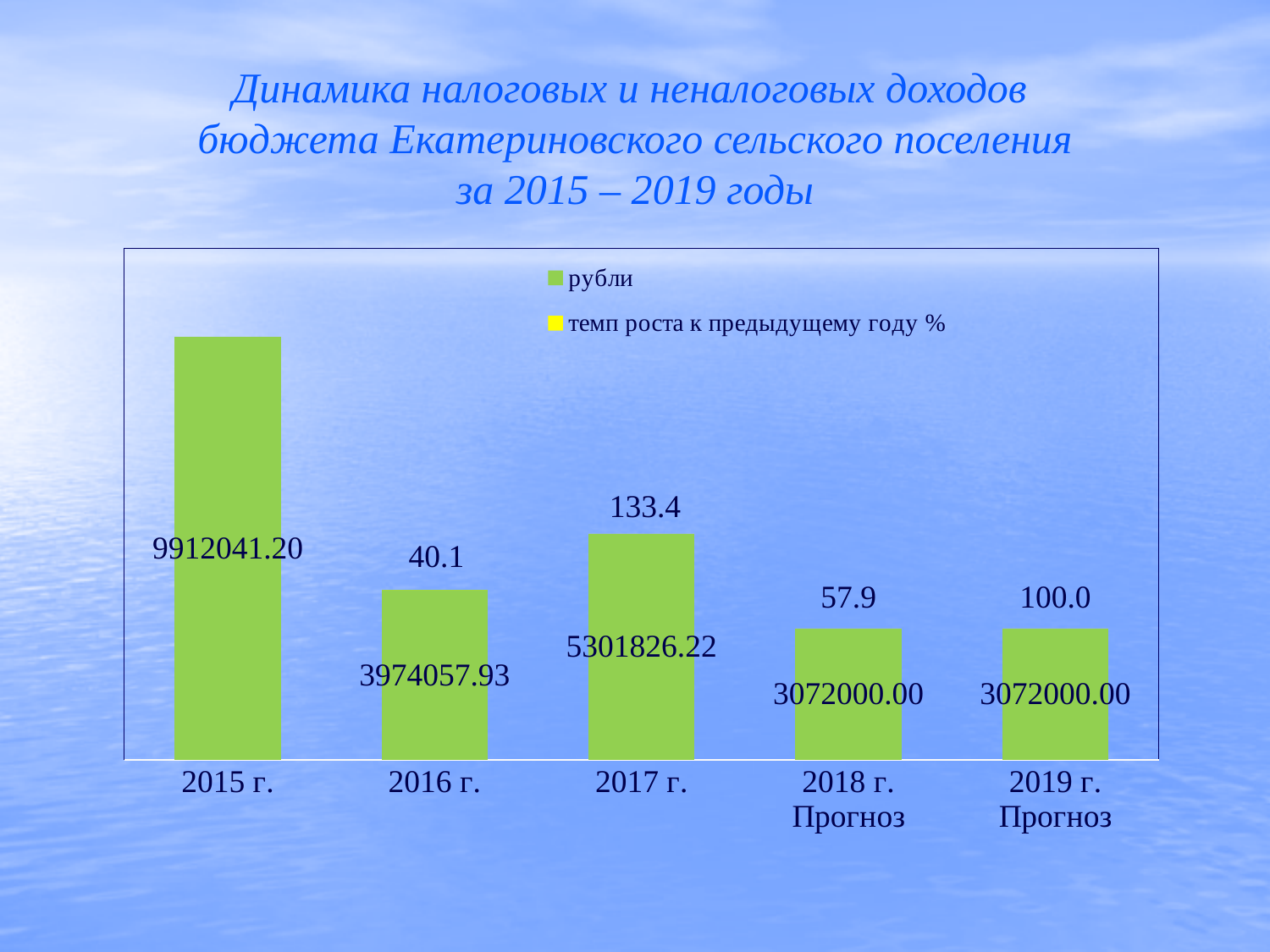
What is the value in рубли for 2017 г.? 5301826.22 Which is larger in рубли: 2016 г. or 2017 г.? 2017 г. How many series does the chart legend list? 2 What is the темп роста к предыдущему году % for 2016 г.? 40.1 What is the value in рубли for 2015 г.? 9912041.20 What is the difference in рубли between 2015 г. and 2016 г.? 5937983.27 What is the value in рубли for 2018 г. Прогноз? 3072000.00 What is the value in рубли for 2016 г.? 3974057.93 What type of chart is shown on the slide? bar chart What is the темп роста к предыдущему году % for 2017 г.? 133.4 Which year has the highest value in рубли? 2015 г. How many categories (years) are shown on the x axis of the chart? 5